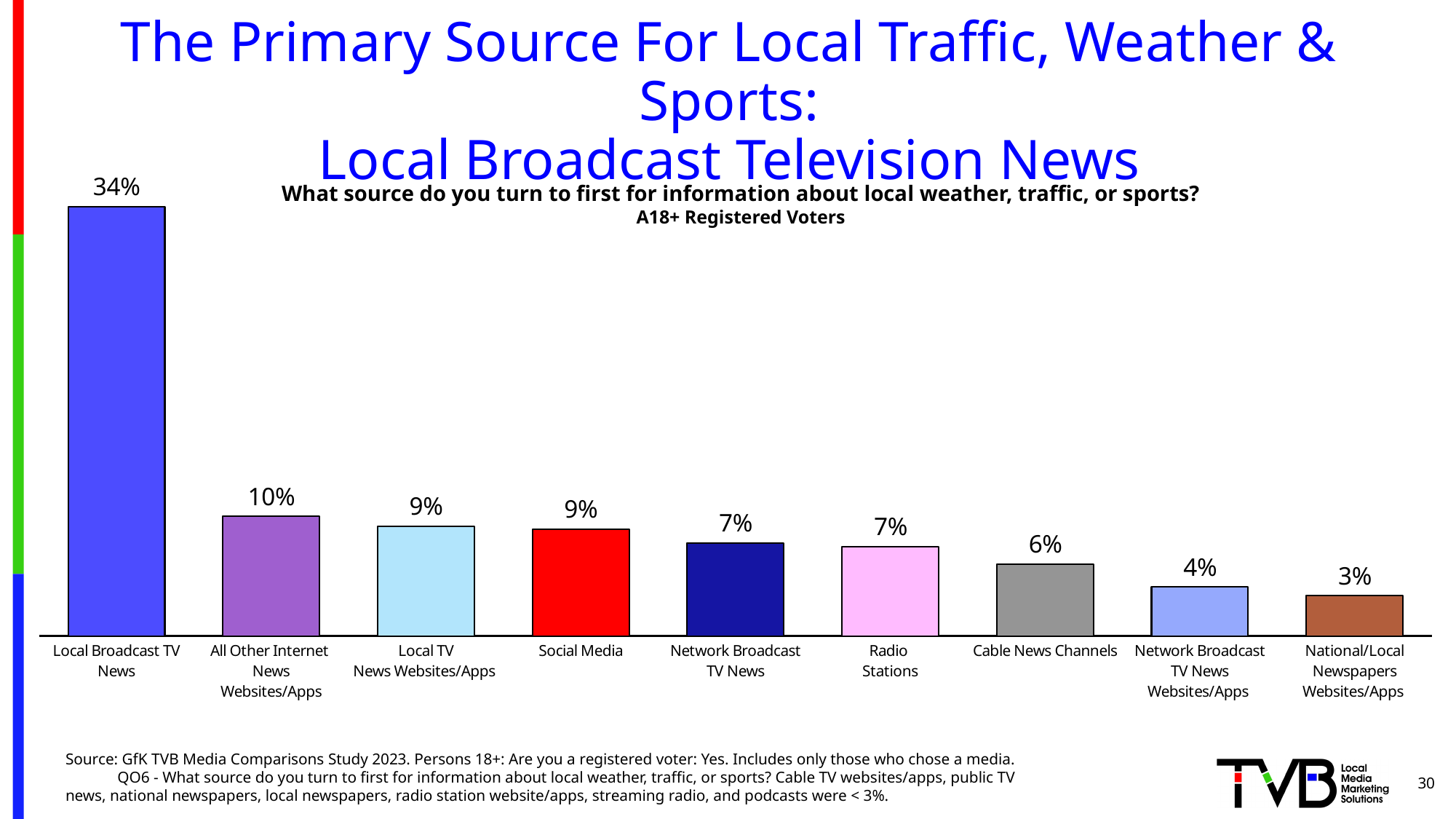
How many sources (bars) are shown in the chart? 9 What percentage of A18+ registered voters turn first to Local Broadcast TV News for local weather, traffic, or sports? 34% Do the values rise or fall moving from left to right across the chart? Fall What is the difference in percentage points between Local Broadcast TV News and All Other Internet News Websites/Apps? 24 What is the value shown for Social Media? 9% What is the value shown for National/Local Newspapers Websites/Apps? 3% What is the value shown for Cable News Channels? 6% What kind of chart is shown on the slide? Bar chart Which source has the lowest percentage? National/Local Newspapers Websites/Apps Which is larger, the value for All Other Internet News Websites/Apps or the value for Cable News Channels? All Other Internet News Websites/Apps What is the difference in percentage points between Radio Stations and Network Broadcast TV News Websites/Apps? 3 Which source has the highest percentage? Local Broadcast TV News